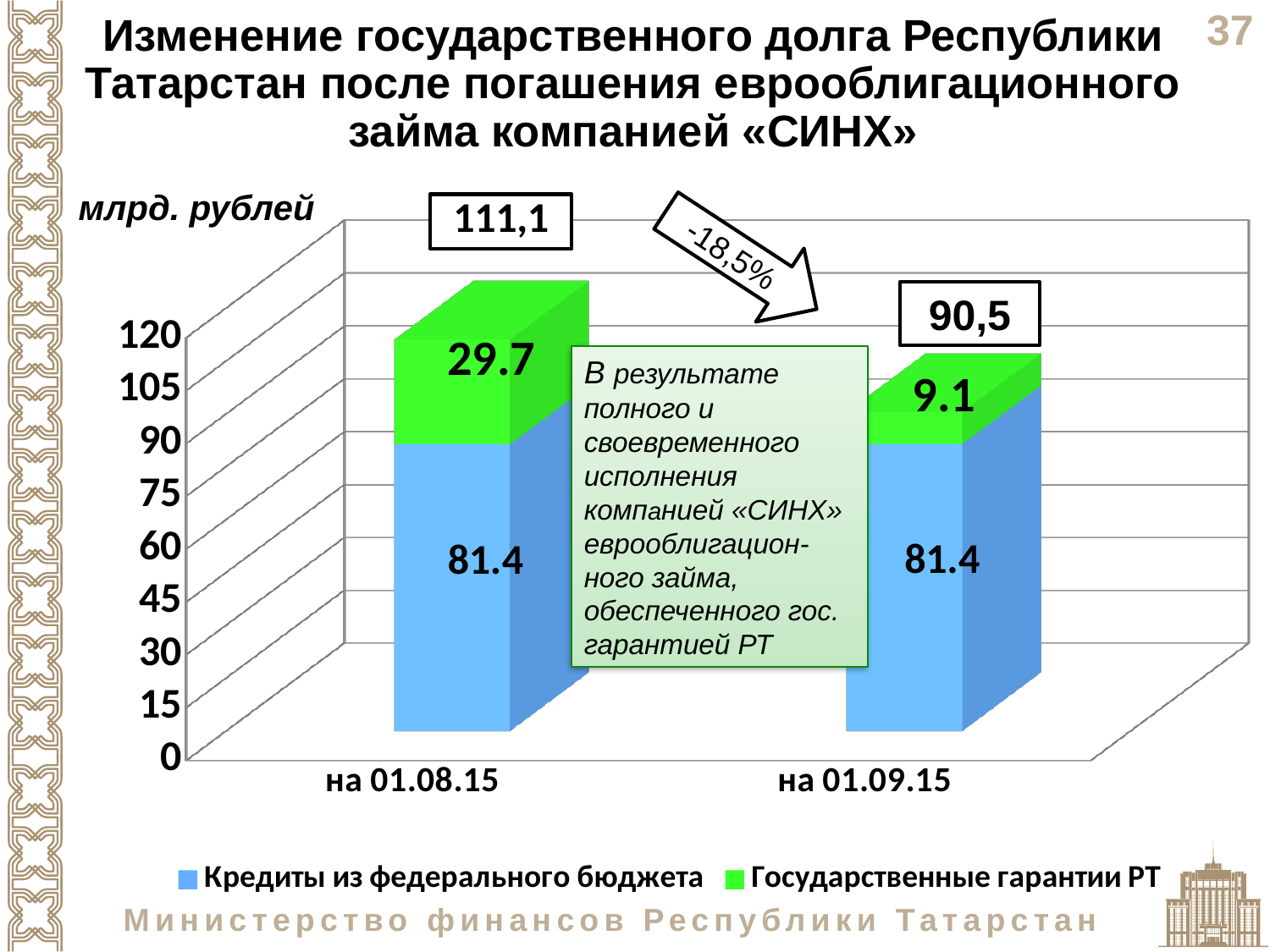
What is the total of the stacked bar for «на 01.09.15»? 90,5 By how much did «Государственные гарантии РТ» decrease from «на 01.08.15» to «на 01.09.15»? 20.6 How many series does the legend list? 2 How many categories are shown on the x axis? 2 What is the value of «Кредиты из федерального бюджета» for «на 01.09.15»? 81.4 What is the value of «Государственные гарантии РТ» for «на 01.09.15»? 9.1 What kind of chart is shown on the slide? Stacked bar chart What percentage change is shown by the arrow between the two bars? -18,5% Which date has the higher value for «Государственные гарантии РТ»? на 01.08.15 Which category has the lowest total debt? на 01.09.15 What is the value of «Государственные гарантии РТ» for «на 01.08.15»? 29.7 What is the total of the stacked bar for «на 01.08.15»? 111,1